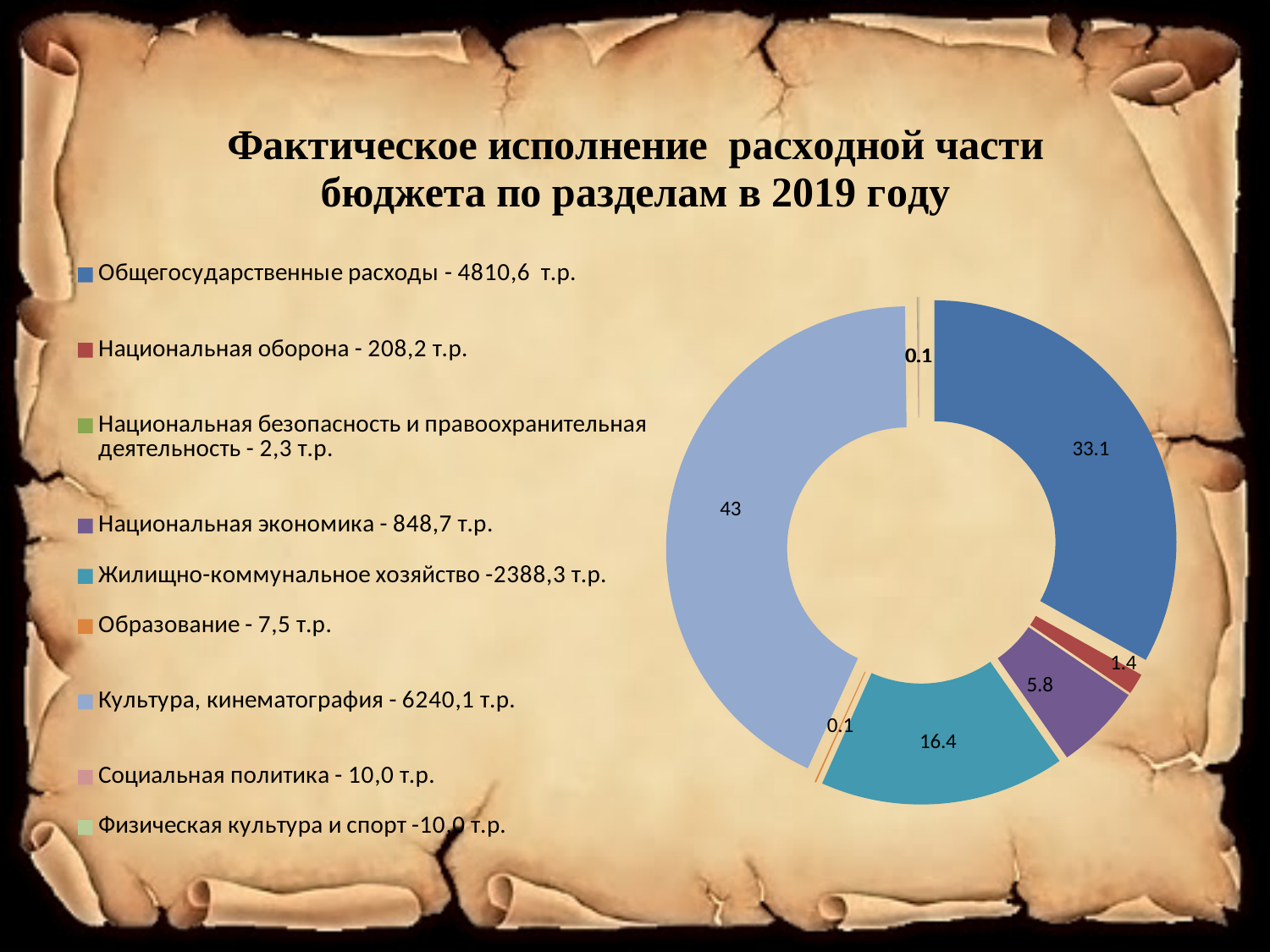
According to the legend, what amount is given for Национальная экономика? 848,7 т.р. Which category has the largest slice in the chart? Культура, кинематография What is the difference between the data labels for Общегосударственные расходы and Жилищно-коммунальное хозяйство? 16.7 What is the data label for the Общегосударственные расходы slice? 33.1 What is the data label for the Национальная оборона slice? 1.4 What is the difference between the data labels for Культура, кинематография and Общегосударственные расходы? 9.9 How many categories does the legend list? 9 What is the data label for the Жилищно-коммунальное хозяйство slice? 16.4 What is the data label for the Национальная экономика slice? 5.8 What kind of chart is shown on the slide? doughnut chart What is the data label for the Культура, кинематография slice? 43 Which slice is larger: Общегосударственные расходы or Жилищно-коммунальное хозяйство? Общегосударственные расходы